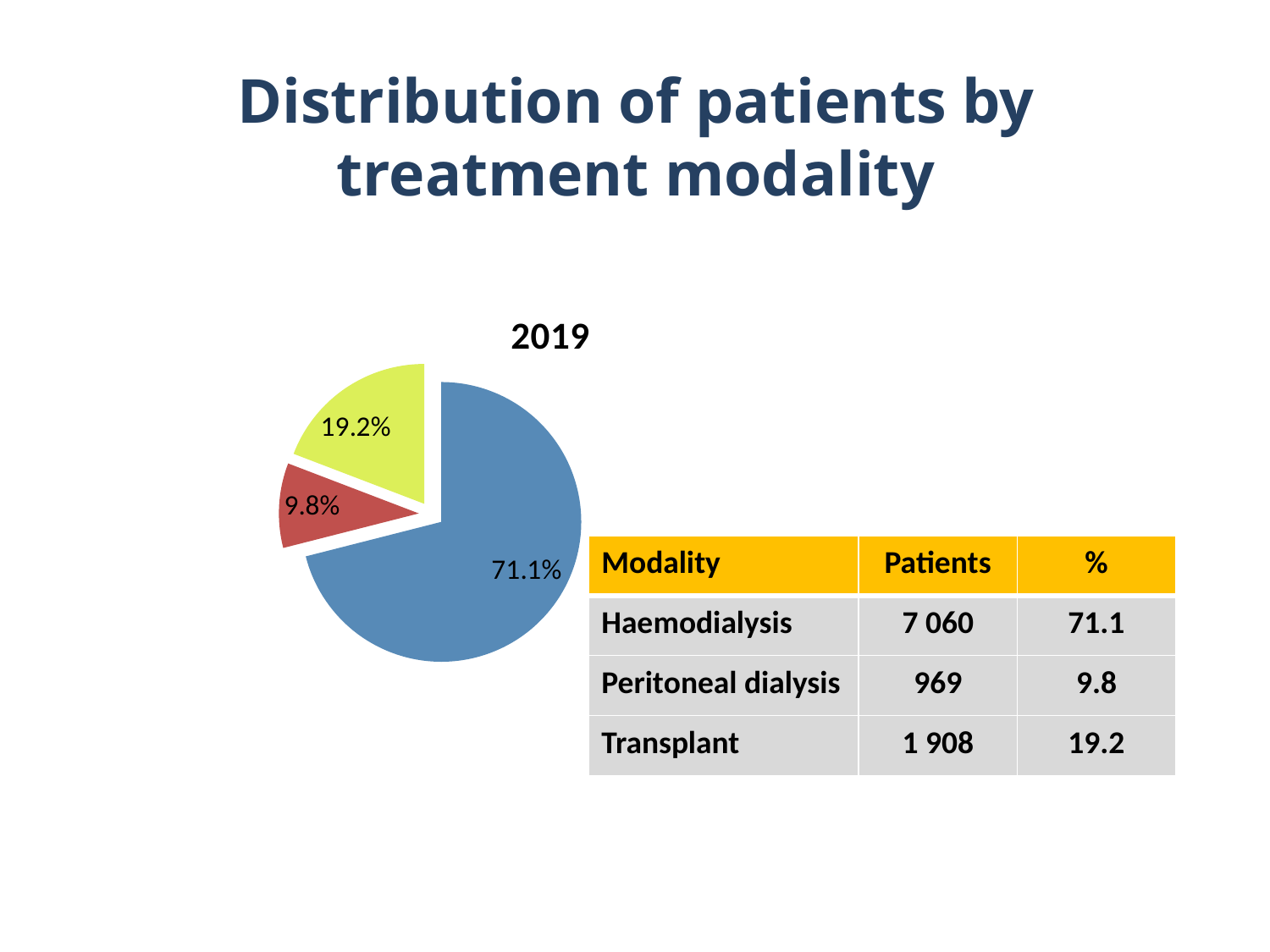
What colour is the largest slice of the pie chart? blue Which is larger in the pie chart, the 19.2% slice or the 9.8% slice? the 19.2% slice What percentage is shown on the smallest slice of the pie chart? 9.8% Is the share of the Transplant slice greater or less than 20%? less What is the difference in percentage points between the 71.1% slice and the 19.2% slice? 51.9 What kind of chart is shown on the slide? pie chart What percentage is shown on the largest slice of the pie chart? 71.1% What share of the pie does the Haemodialysis slice represent? 71.1% What share of the pie does the Transplant slice represent? 19.2% How many slices does the pie chart have? 3 What share of the pie does the Peritoneal dialysis slice represent? 9.8% What is the title of the pie chart? 2019